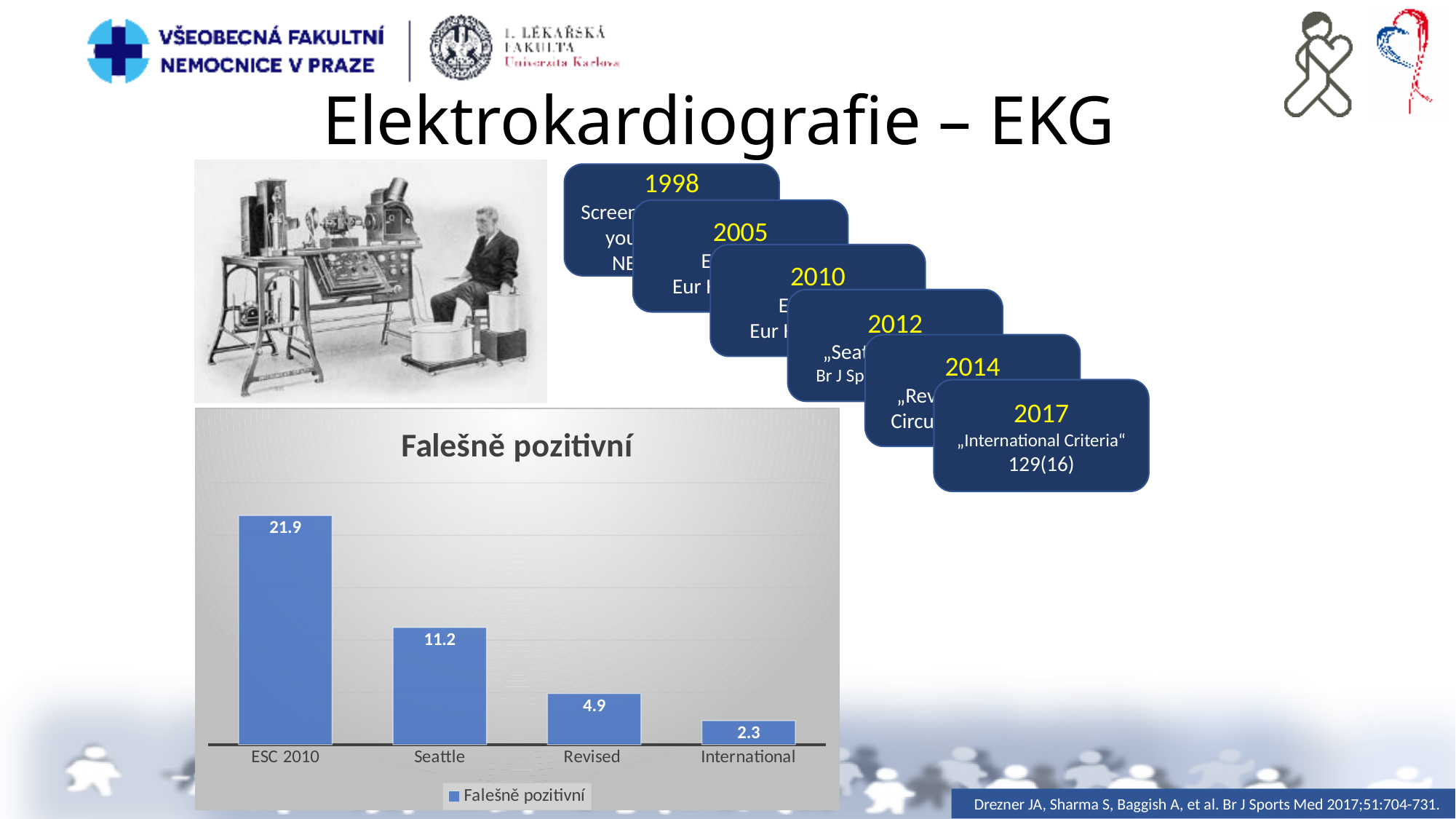
How many categories are shown in the Falešně pozitivní chart? 4 What is the value for International in the Falešně pozitivní chart? 2.3 Which category has the lowest value in the Falešně pozitivní chart? International Do the values in the Falešně pozitivní chart rise or fall from left to right? fall What is the value for Revised in the Falešně pozitivní chart? 4.9 Which category has the highest value in the Falešně pozitivní chart? ESC 2010 Which is larger in the Falešně pozitivní chart, Seattle or Revised? Seattle What is the value for ESC 2010 in the Falešně pozitivní chart? 21.9 What kind of chart is the Falešně pozitivní chart? bar chart What is the difference between the Revised and International values in the Falešně pozitivní chart? 2.6 What is the difference between the ESC 2010 and Seattle values in the Falešně pozitivní chart? 10.7 What is the value for Seattle in the Falešně pozitivní chart? 11.2